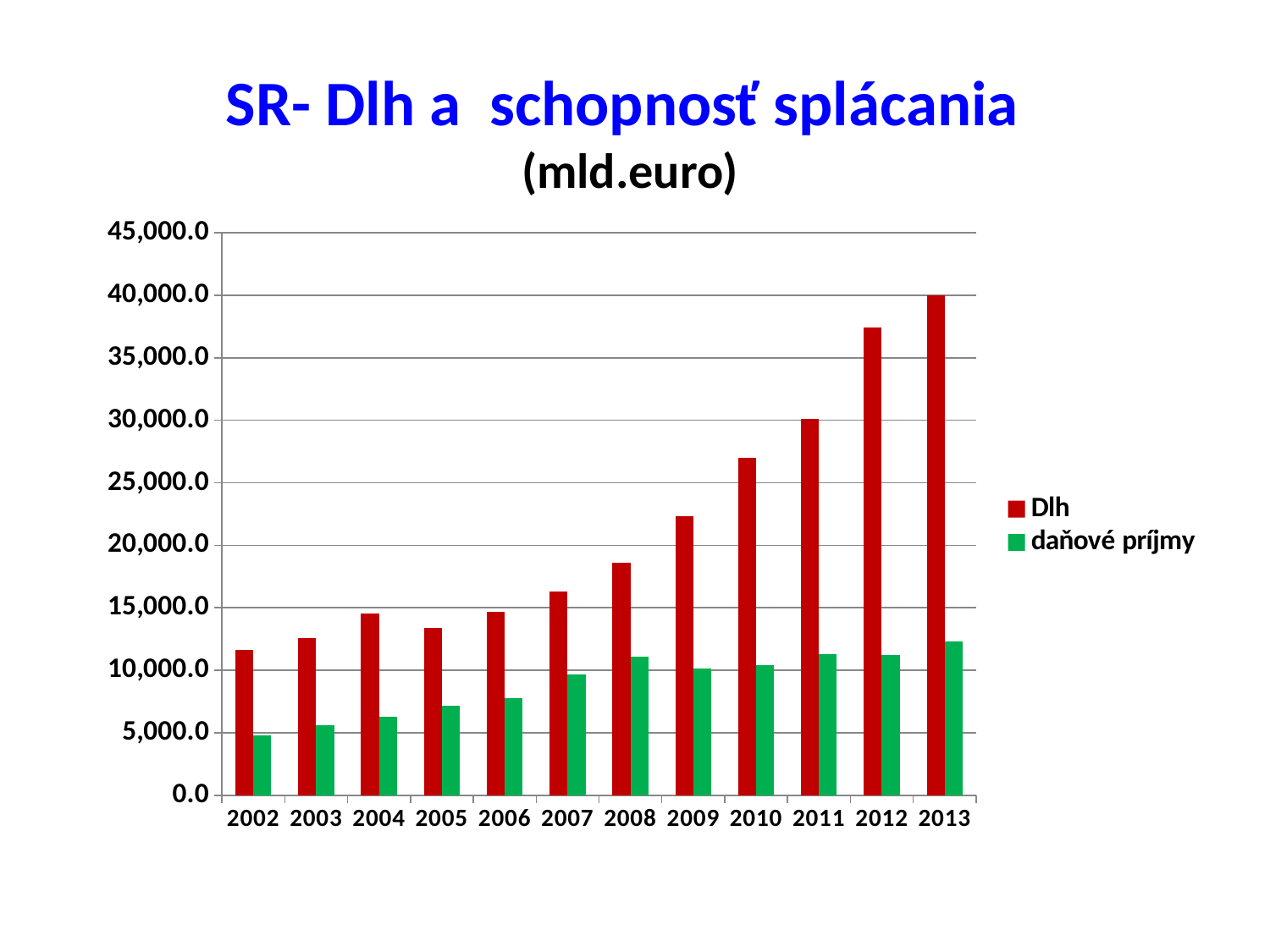
Is the Dlh value for 2012 greater or less than 35,000.0? greater How many series does the legend list? 2 In which year is the Dlh value lowest? 2002 In which year is the Dlh value highest? 2013 Which is larger, the Dlh value for 2010 or for 2011? 2011 In which year is the daňové príjmy value highest? 2013 What kind of chart is shown on the slide? bar chart Is the daňové príjmy value for 2002 greater or less than 5,000.0? less Is the Dlh value for 2009 greater or less than 20,000.0? greater In which year is the daňové príjmy value lowest? 2002 How many years are shown on the x axis? 12 Does the Dlh series generally rise or fall from 2002 to 2013? rise